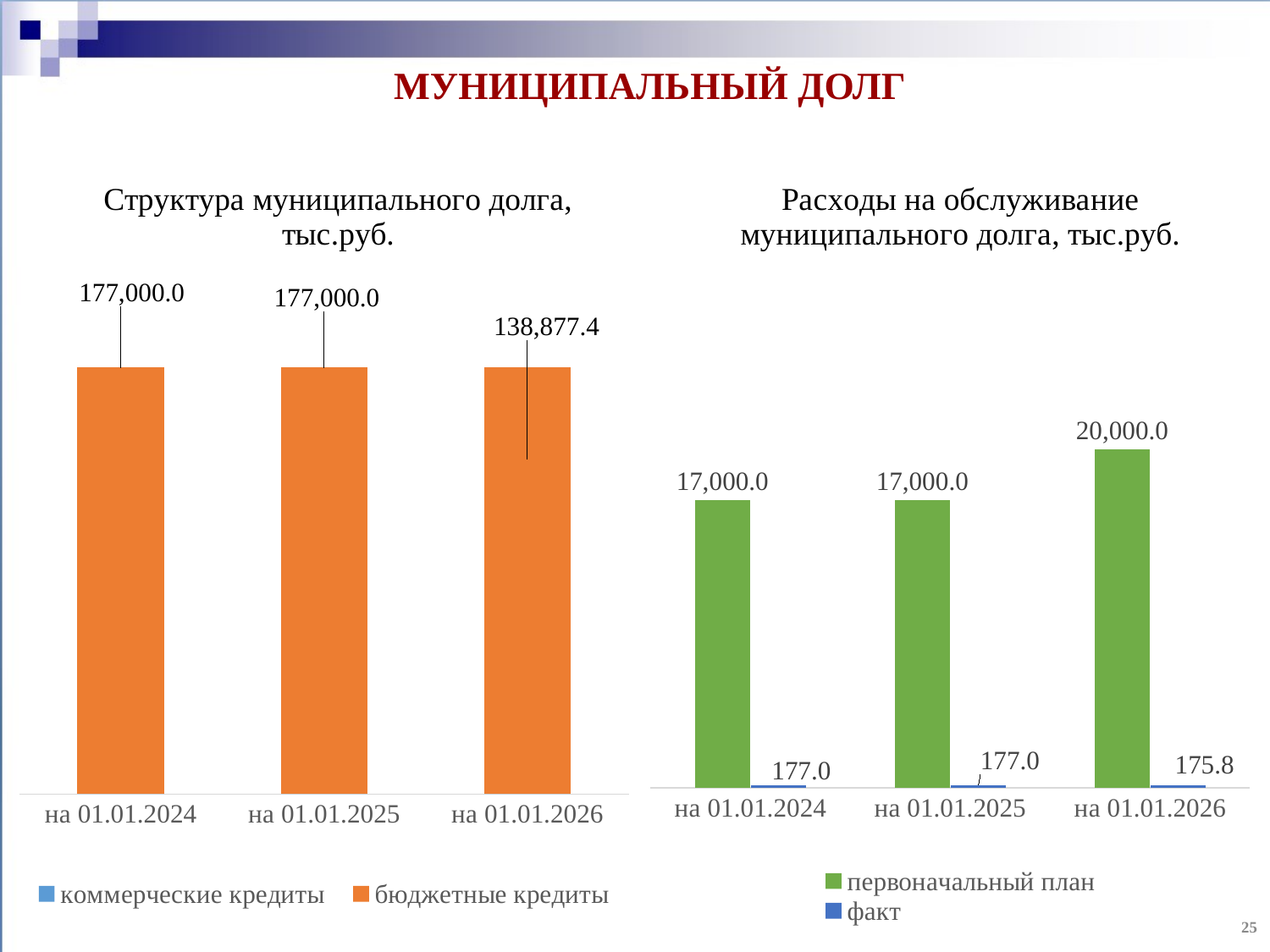
In the chart titled "Расходы на обслуживание муниципального долга, тыс.руб.", which is larger: факт на 01.01.2024 or факт на 01.01.2026? на 01.01.2024 In the chart titled "Структура муниципального долга, тыс.руб.", what is the difference between the бюджетные кредиты values на 01.01.2025 and на 01.01.2026? 38,122.6 In the chart titled "Расходы на обслуживание муниципального долга, тыс.руб.", what are the two legend entries? первоначальный план, факт In the chart titled "Структура муниципального долга, тыс.руб.", how many dates are shown on the x axis? 3 In the chart titled "Расходы на обслуживание муниципального долга, тыс.руб.", what is the value for факт на 01.01.2026? 175.8 In the chart titled "Расходы на обслуживание муниципального долга, тыс.руб.", on which date is первоначальный план highest? на 01.01.2026 In the chart titled "Структура муниципального долга, тыс.руб.", what is the value for бюджетные кредиты на 01.01.2026? 138,877.4 In the chart titled "Расходы на обслуживание муниципального долга, тыс.руб.", what is the difference between первоначальный план на 01.01.2026 and на 01.01.2025? 3,000.0 In the chart titled "Структура муниципального долга, тыс.руб.", how many series does the legend list? 2 In the chart titled "Расходы на обслуживание муниципального долга, тыс.руб.", what is the value for первоначальный план на 01.01.2026? 20,000.0 In the chart titled "Структура муниципального долга, тыс.руб.", what is the value for бюджетные кредиты на 01.01.2024? 177,000.0 What kind of chart is the chart titled "Расходы на обслуживание муниципального долга, тыс.руб."? bar chart